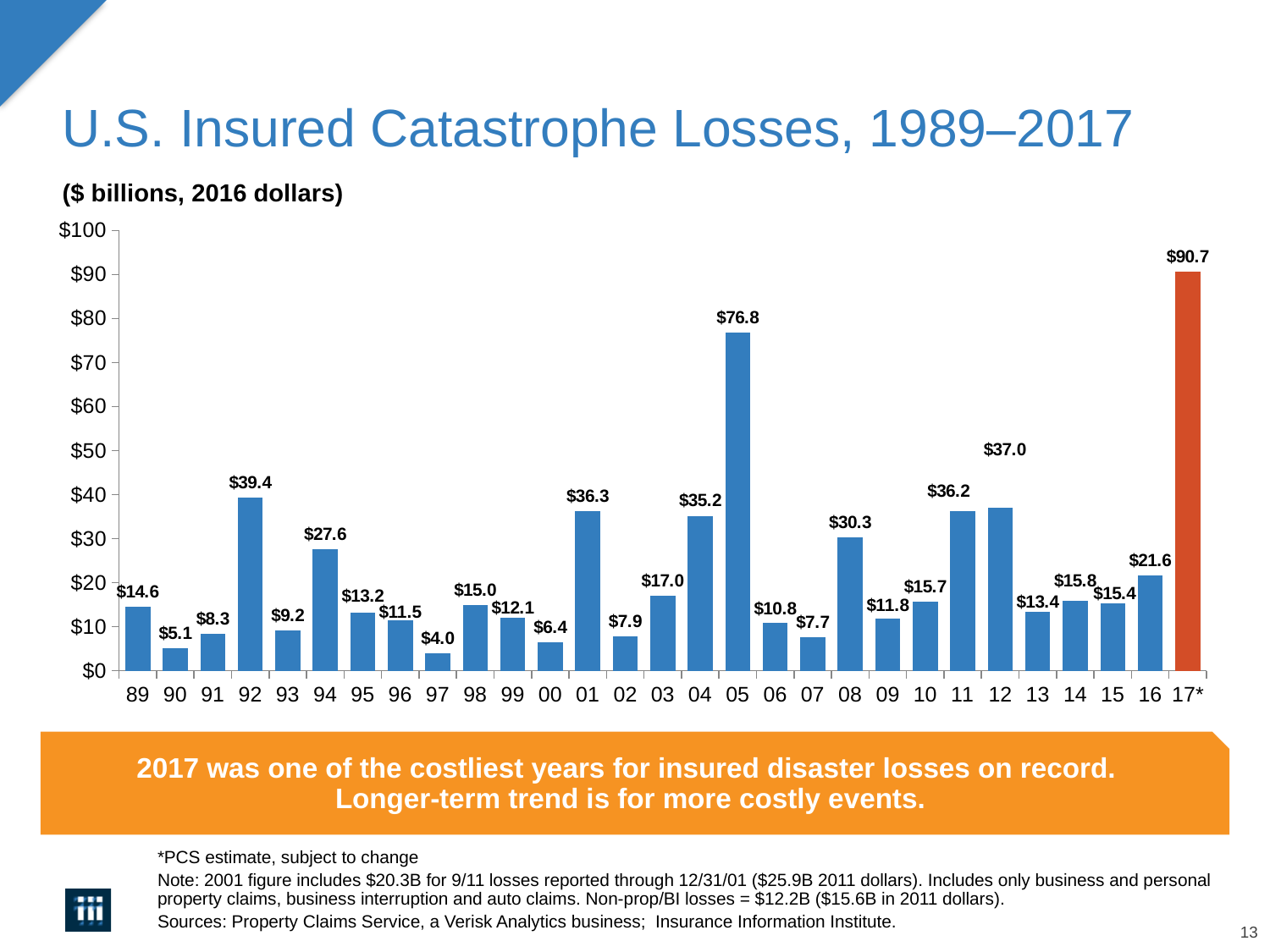
What units are the values on the chart expressed in? $ billions, 2016 dollars How many years (bars) are shown on the chart? 29 What kind of chart is shown on the slide? Bar chart Which year has the lowest insured catastrophe losses? 97 Is the value for 16 greater or less than $20? greater What is the value for 2017 (17*)? $90.7 Which is larger, the value for 01 or the value for 04? 01 Which year has the highest insured catastrophe losses? 17* Which is larger, the value for 12 or the value for 11? 12 What is the value for 2005 (05)? $76.8 What is the difference between the values for 17* and 05? $13.9 What is the value for 1992 (92)? $39.4